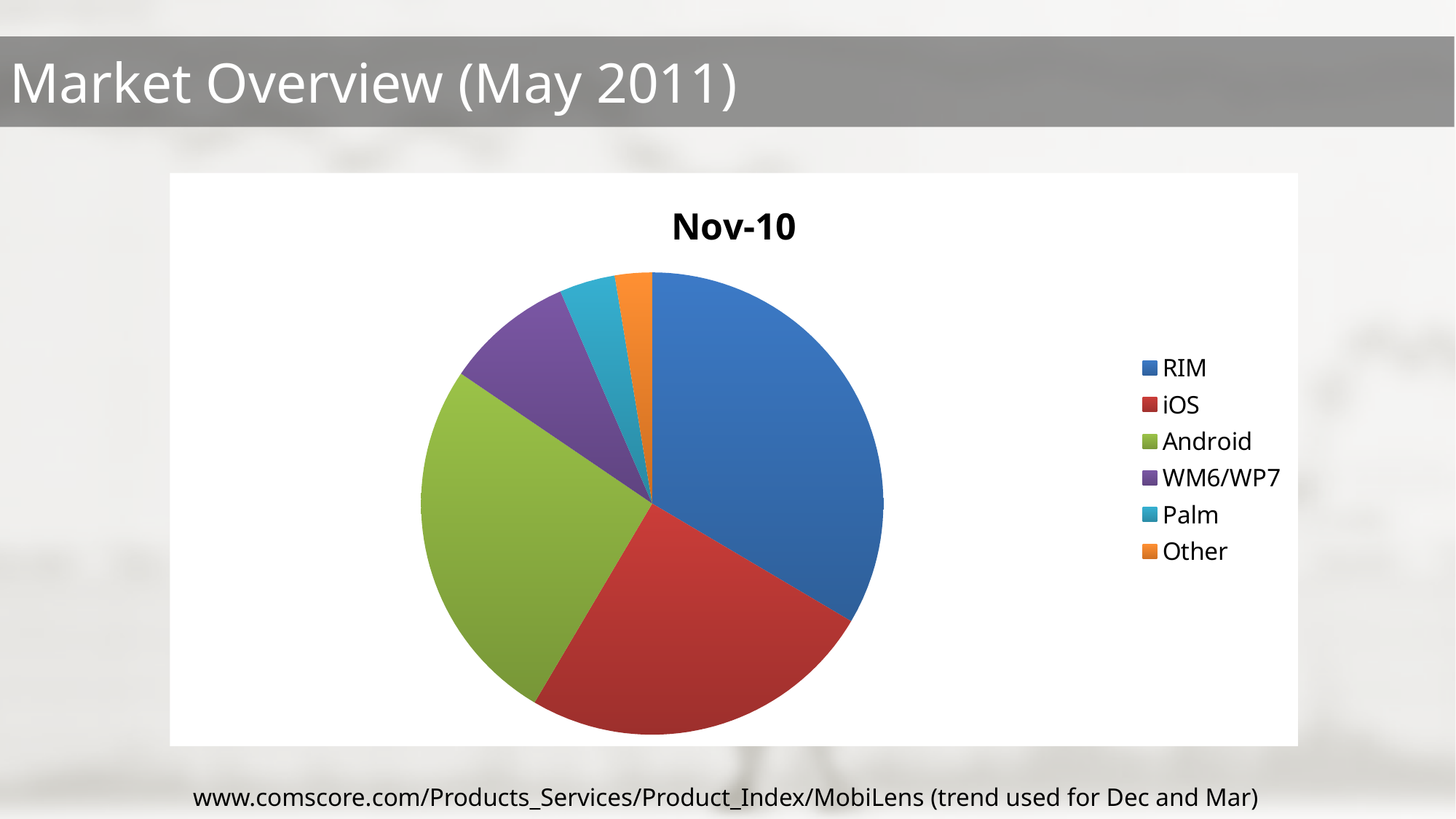
Which category is shown in orange in the pie chart? Other Which category has the largest slice of the pie? RIM Which colour represents Android in the pie chart? green Which slice is larger, RIM or Palm? RIM Which slice is larger, WM6/WP7 or Palm? WM6/WP7 What kind of chart is shown on the slide? pie chart What is the title of the chart? Nov-10 How many categories does the legend of the pie chart list? 6 Which slice is larger, Android or WM6/WP7? Android Which category has the smallest slice of the pie? Other